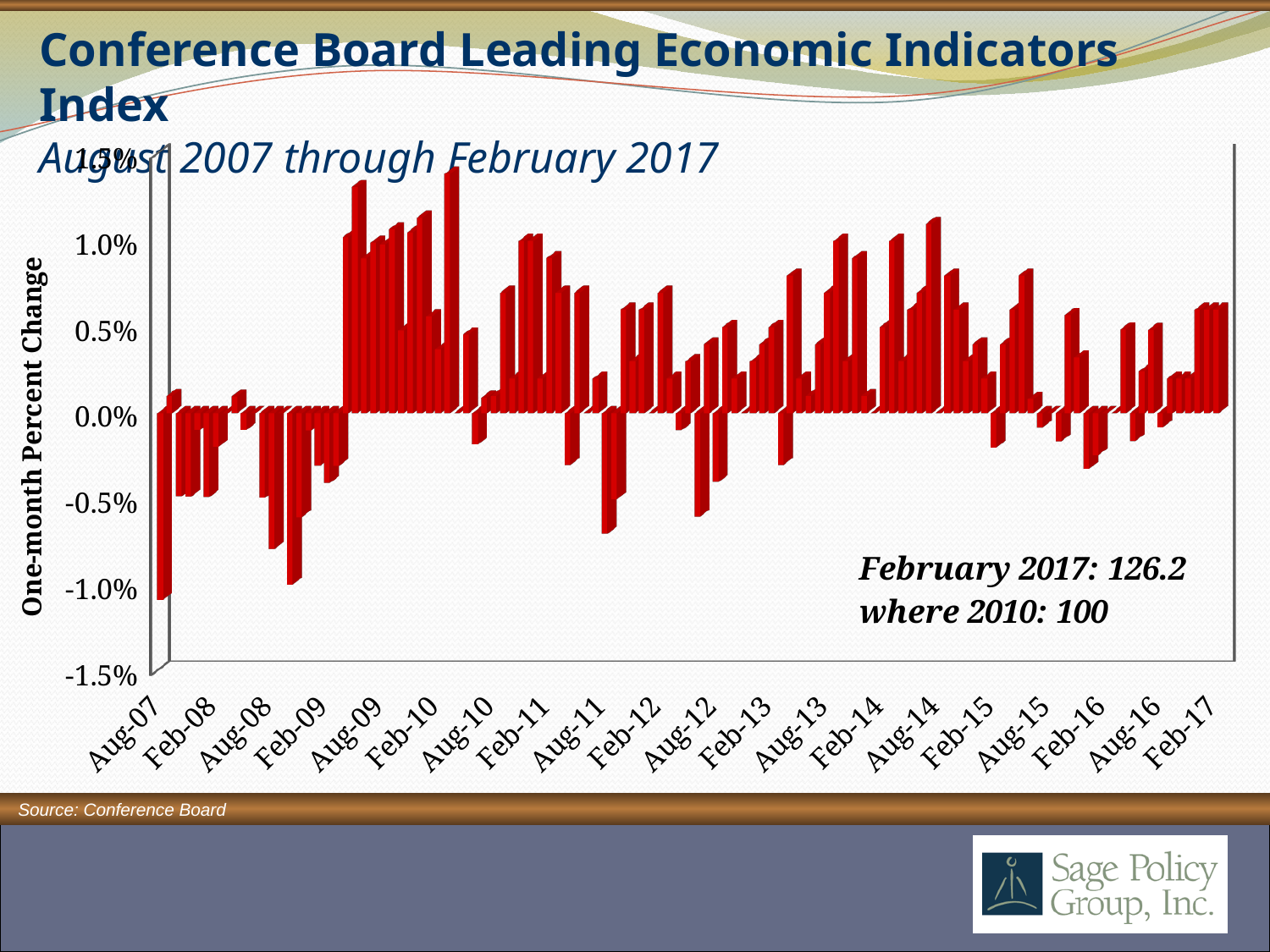
What is the title of the chart on the slide? Conference Board Leading Economic Indicators Index What is the highest value shown on the vertical axis of the chart? 1.5% According to the annotation on the chart, what is the index value for February 2017? 126.2 Is the tallest bar on the chart greater or less than 1.0%? greater What is the lowest value shown on the vertical axis of the chart? -1.5% Is the value for Feb-17, the last bar on the chart, greater or less than 0.5%? greater Which of the two is larger: the value for Aug-07 (the first bar) or the value for Feb-17 (the last bar)? Feb-17 According to the annotation on the chart, what is the base year in which the index equals 100? 2010 How many date labels are shown along the horizontal axis of the chart? 20 Is the value for Aug-07, the first bar on the chart, greater or less than -0.5%? less What kind of chart is shown on the slide? Bar chart What is the label on the vertical axis of the chart? One-month Percent Change